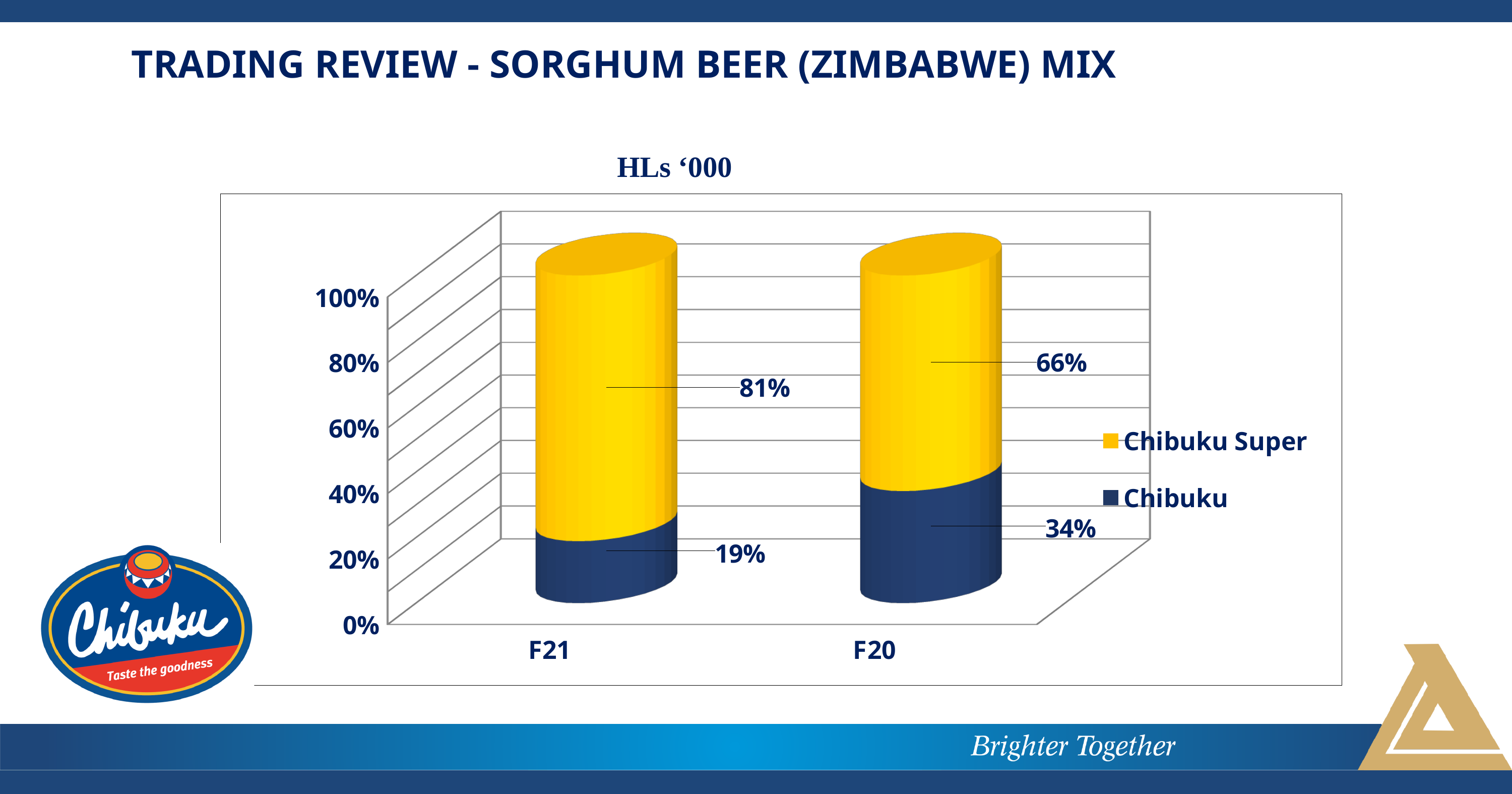
Which year has the lower Chibuku share? F21 What is the difference between the Chibuku Super share in F21 and in F20? 15% Which year has the higher Chibuku Super share, F21 or F20? F21 How many categories are shown on the x axis? 2 What is the Chibuku Super share for F20? 66% What is the Chibuku share for F21? 19% How many series does the legend list? 2 What is the Chibuku Super share for F21? 81% What is the Chibuku share for F20? 34% What is the title shown above the chart? HLs '000 What kind of chart is shown on the slide? Stacked bar chart What is the difference between the Chibuku share in F20 and in F21? 15%